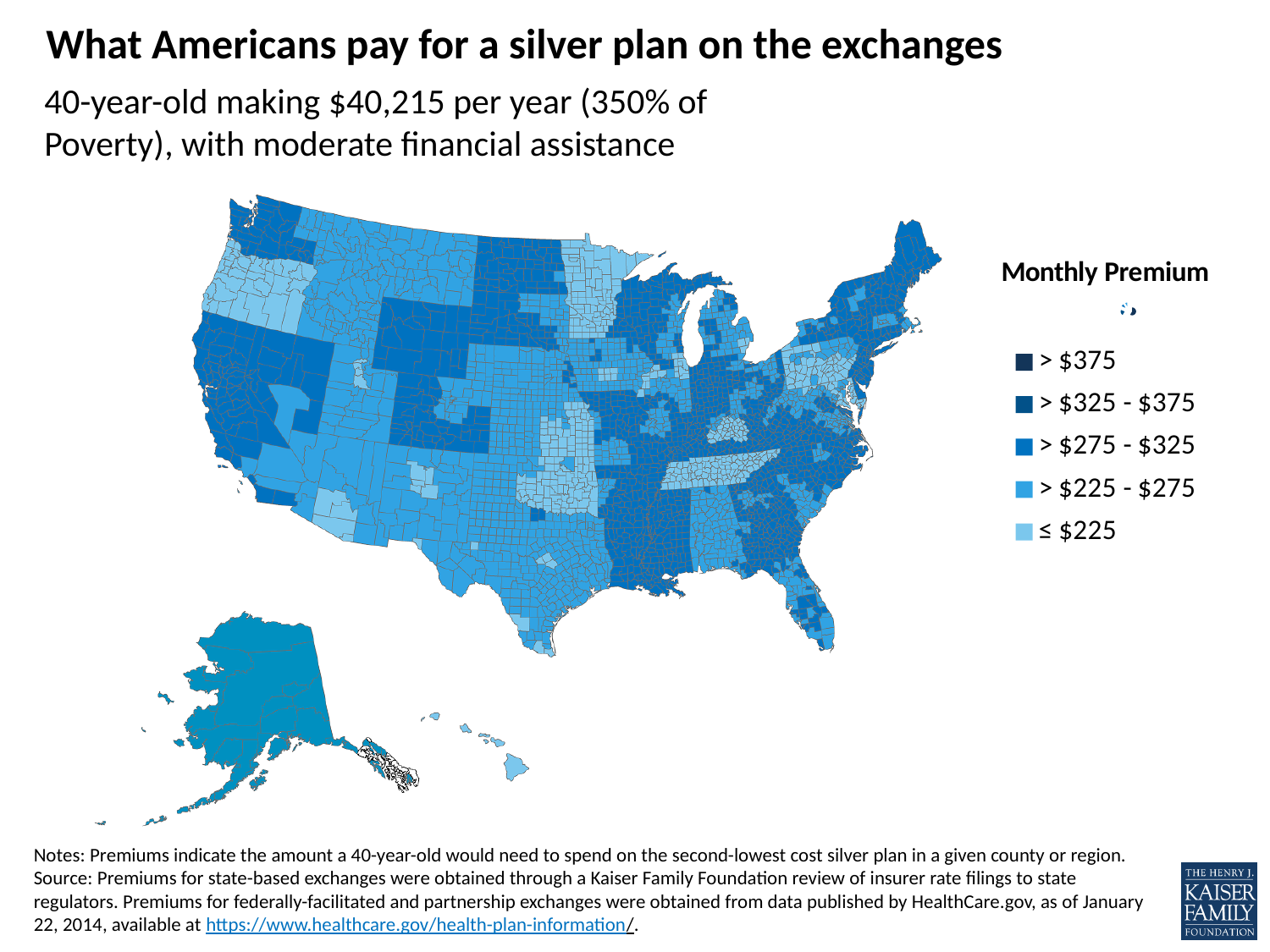
Which monthly premium range is represented by the darkest blue shade on the map? > $375 What monthly premium range lies between > $275 - $325 and > $375 in the legend? > $325 - $375 What is the highest monthly premium range shown in the legend? > $375 What is the title of the chart on the slide? What Americans pay for a silver plan on the exchanges What kind of chart is shown on the slide? A map (choropleth map) Do darker shades on the map indicate higher or lower monthly premiums? Higher What is the lowest monthly premium range shown in the legend? ≤ $225 What percent of poverty does the subtitle say the $40,215 income corresponds to? 350% How many monthly premium categories does the map legend list? 5 What annual income does the subtitle specify for the 40-year-old in this map? $40,215 per year Which monthly premium range is represented by the lightest blue shade on the map? ≤ $225 What is the title of the map's legend? Monthly Premium